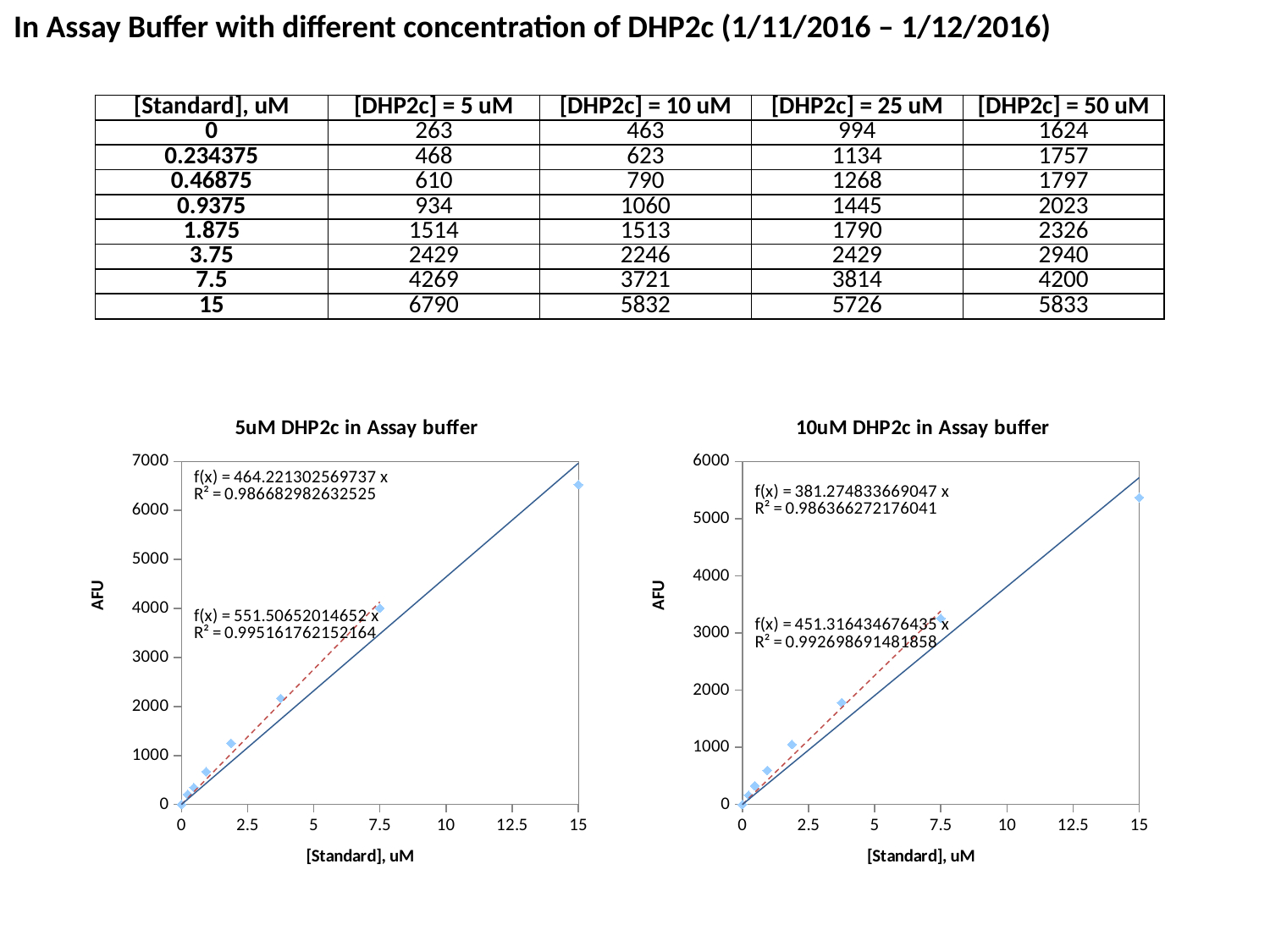
How many data points are plotted in the "5uM DHP2c in Assay buffer" chart? 8 What kind of chart is the "5uM DHP2c in Assay buffer" chart? Scatter chart In the "5uM DHP2c in Assay buffer" chart, is the AFU value at [Standard] = 3.75 uM greater or less than 2000? greater In the "5uM DHP2c in Assay buffer" chart, is the AFU value at [Standard] = 15 uM greater or less than 6000? greater What is the R² value shown for the upper trendline equation in the "5uM DHP2c in Assay buffer" chart? 0.986682982632525 In the "10uM DHP2c in Assay buffer" chart, is the AFU value at [Standard] = 15 uM greater or less than 5000? greater In the "10uM DHP2c in Assay buffer" chart, at which [Standard] concentration is the AFU value highest? 15 How many data points are plotted in the "10uM DHP2c in Assay buffer" chart? 8 What is the y-axis label of the "10uM DHP2c in Assay buffer" chart? AFU In the "5uM DHP2c in Assay buffer" chart, do the AFU values rise or fall as [Standard], uM increases? Rise In the "10uM DHP2c in Assay buffer" chart, do the AFU values rise or fall as [Standard], uM increases? Rise